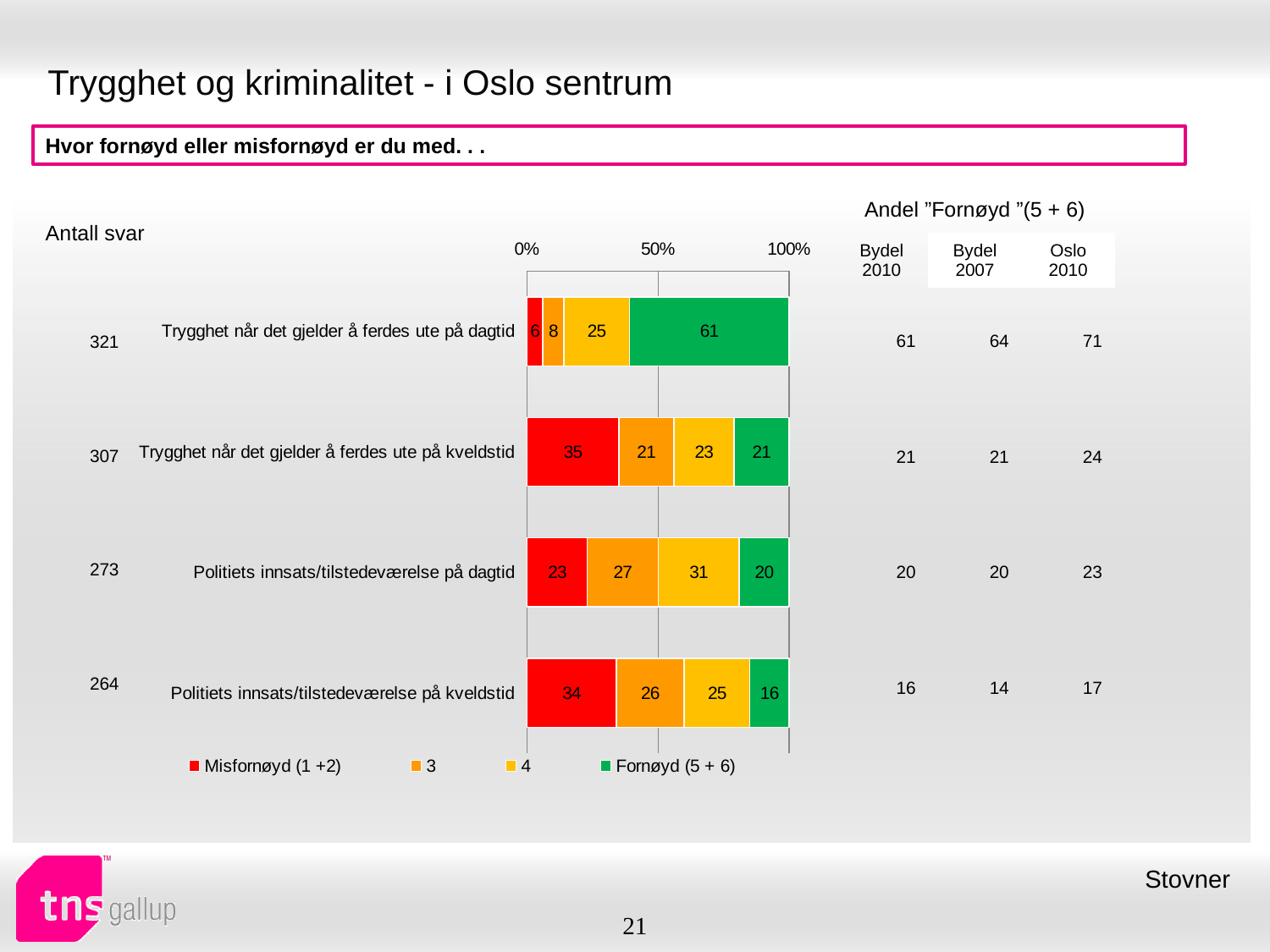
What is the difference between the "Fornøyd (5 + 6)" values for "Trygghet når det gjelder å ferdes ute på dagtid" and "Trygghet når det gjelder å ferdes ute på kveldstid"? 40 What is the value of the "Fornøyd (5 + 6)" segment for "Trygghet når det gjelder å ferdes ute på dagtid"? 61 What is the value of the "4" segment for "Politiets innsats/tilstedeværelse på dagtid"? 31 What is the value of the "Misfornøyd (1 +2)" segment for "Trygghet når det gjelder å ferdes ute på kveldstid"? 35 How many categories are shown in the chart? 4 Which category has the lowest "Misfornøyd (1 +2)" value? Trygghet når det gjelder å ferdes ute på dagtid What kind of chart is shown on the slide? Stacked bar chart Which category has the highest "Fornøyd (5 + 6)" value? Trygghet når det gjelder å ferdes ute på dagtid How many series does the legend list? 4 Which is larger: the "Misfornøyd (1 +2)" value for "Politiets innsats/tilstedeværelse på dagtid" or for "Politiets innsats/tilstedeværelse på kveldstid"? Politiets innsats/tilstedeværelse på kveldstid What is the value of the "3" segment for "Politiets innsats/tilstedeværelse på kveldstid"? 26 What is the total of the stacked bar for "Politiets innsats/tilstedeværelse på dagtid"? 101